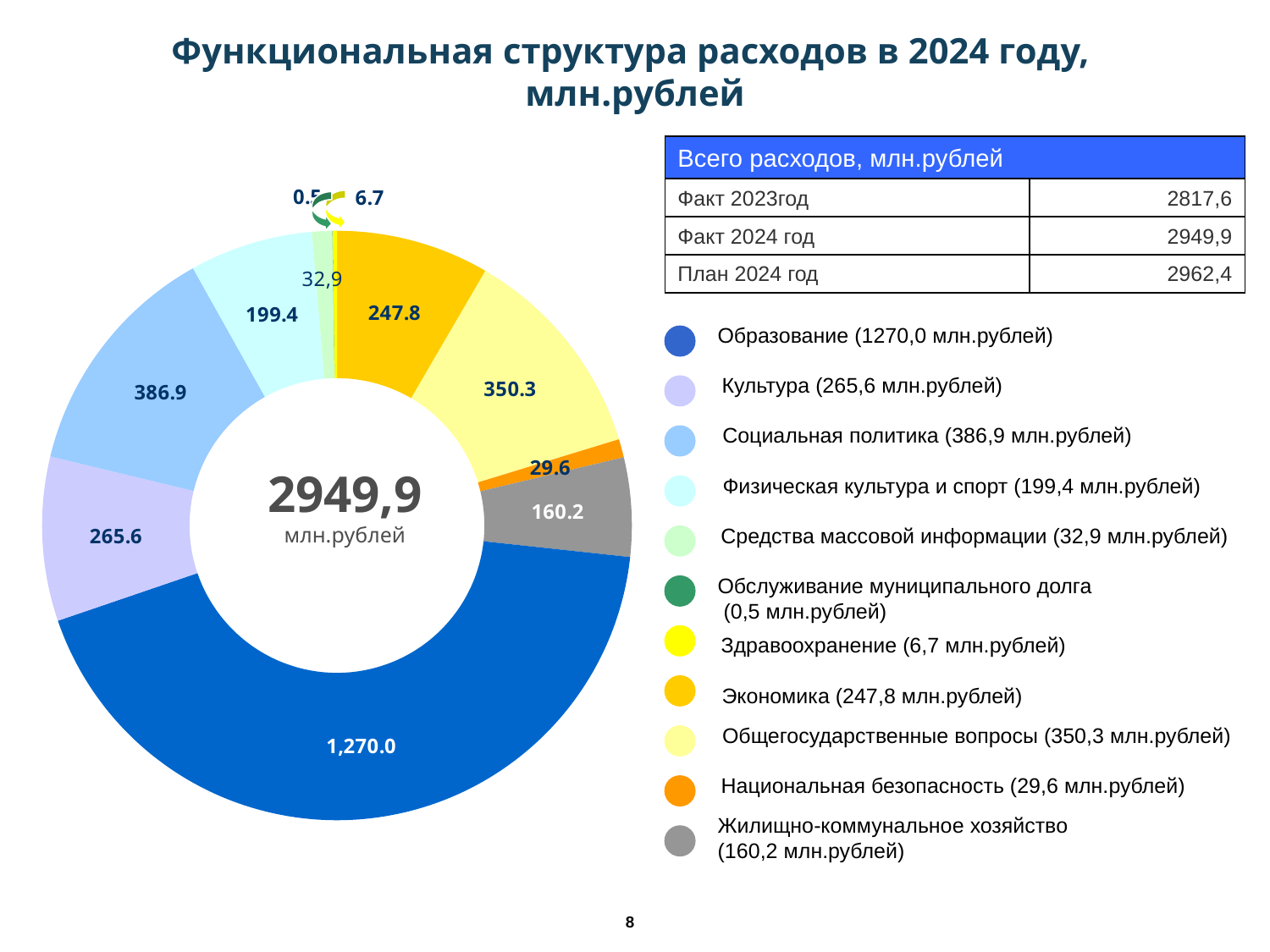
What is the value shown for Экономика? 247.8 Which category has the smallest value in the chart? Обслуживание муниципального долга What is the value shown for Здравоохранение? 6.7 Which category has the largest value in the chart? Образование What total value is shown in the centre of the donut chart? 2949,9 млн.рублей What is the value shown for Социальная политика? 386.9 What is the value shown for Жилищно-коммунальное хозяйство? 160.2 What is the difference between the values for Социальная политика and Культура? 121.3 How many categories does the legend of the chart list? 11 What kind of chart is shown on the slide? Pie (donut) chart Which is larger: Общегосударственные вопросы or Экономика? Общегосударственные вопросы What is the title of the slide's chart? Функциональная структура расходов в 2024 году, млн.рублей